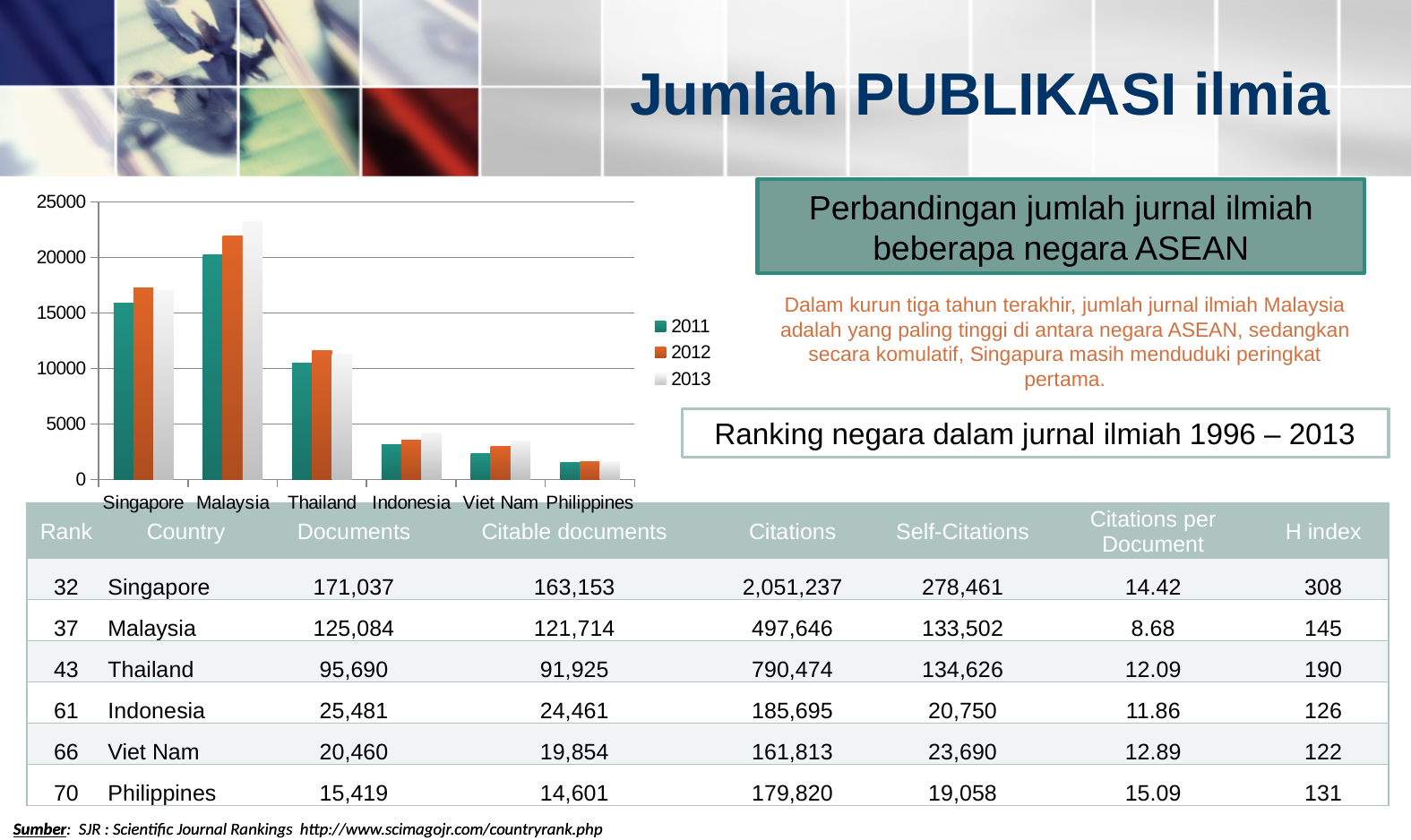
Is the value for Malaysia in 2013 greater or less than 20000? greater How many countries are shown on the x axis of the chart? 6 What years are listed in the chart legend? 2011, 2012, 2013 Do the values for Malaysia rise or fall from 2011 to 2013? rise Which country has the lowest bars in the chart? Philippines Which is larger in 2013, the value for Singapore or the value for Malaysia? Malaysia Is the value for Indonesia in 2013 greater or less than 5000? less Is the value for Singapore in 2011 greater or less than 15000? greater What kind of chart is shown on the slide? bar chart Which country has the highest bar for 2013 in the chart? Malaysia How many series does the chart legend list? 3